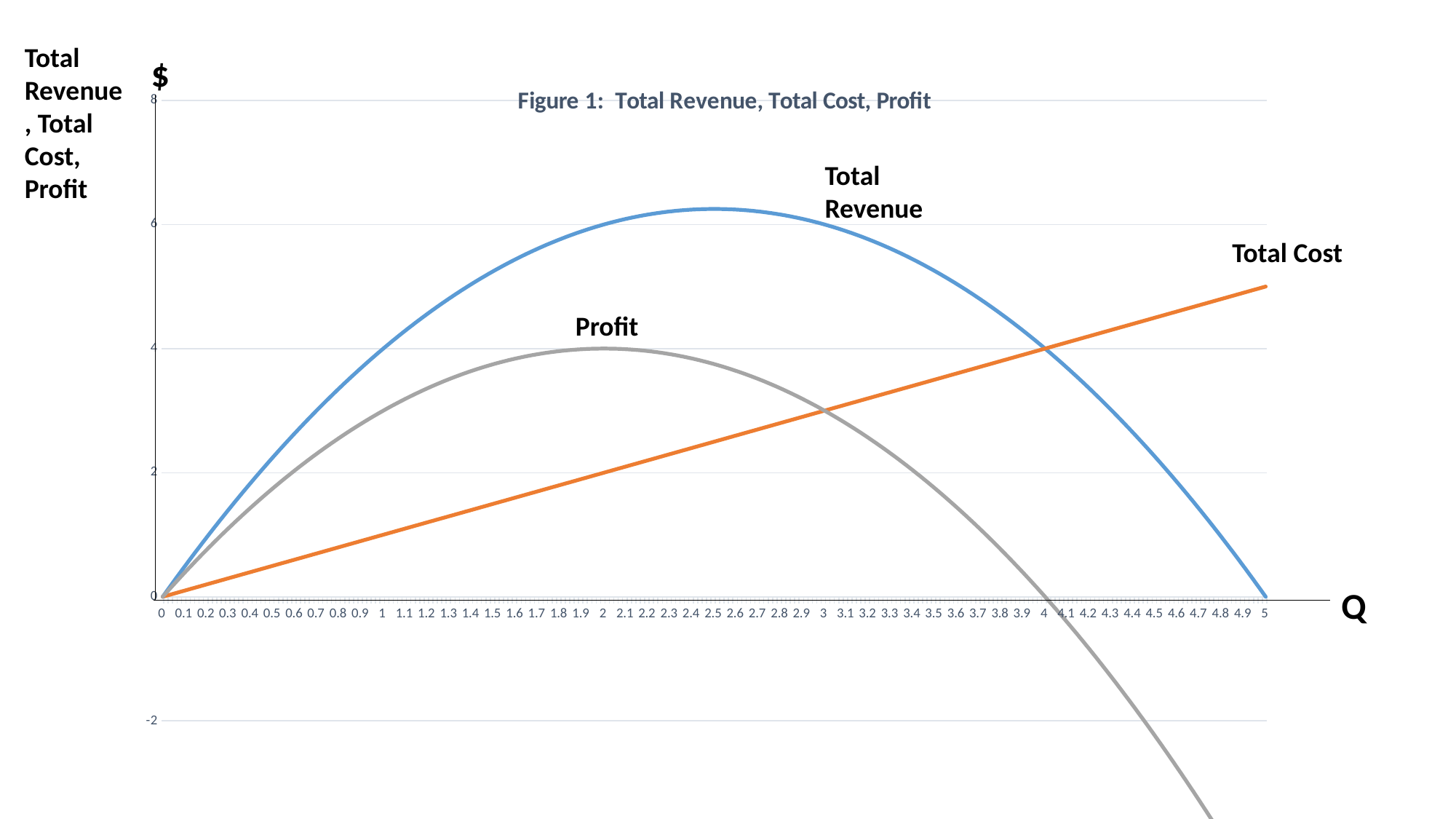
What is the value of Total Cost at Q = 4? 4 What is the title of the chart? Figure 1: Total Revenue, Total Cost, Profit Is the value of Total Cost at Q = 1 greater or less than 2? less How many series are plotted on the chart? 3 What kind of chart is shown on the slide? line chart What is the value of Profit at Q = 2? 4 At Q = 4.5, which is larger, Total Cost or Total Revenue? Total Cost Is the value of Profit at Q = 5 greater or less than -2? less What is the value of Total Revenue at Q = 5? 0 Which series has the highest value at Q = 2.5? Total Revenue Does the Total Cost line rise or fall as Q increases? rises What is the value of Profit at Q = 4? 0